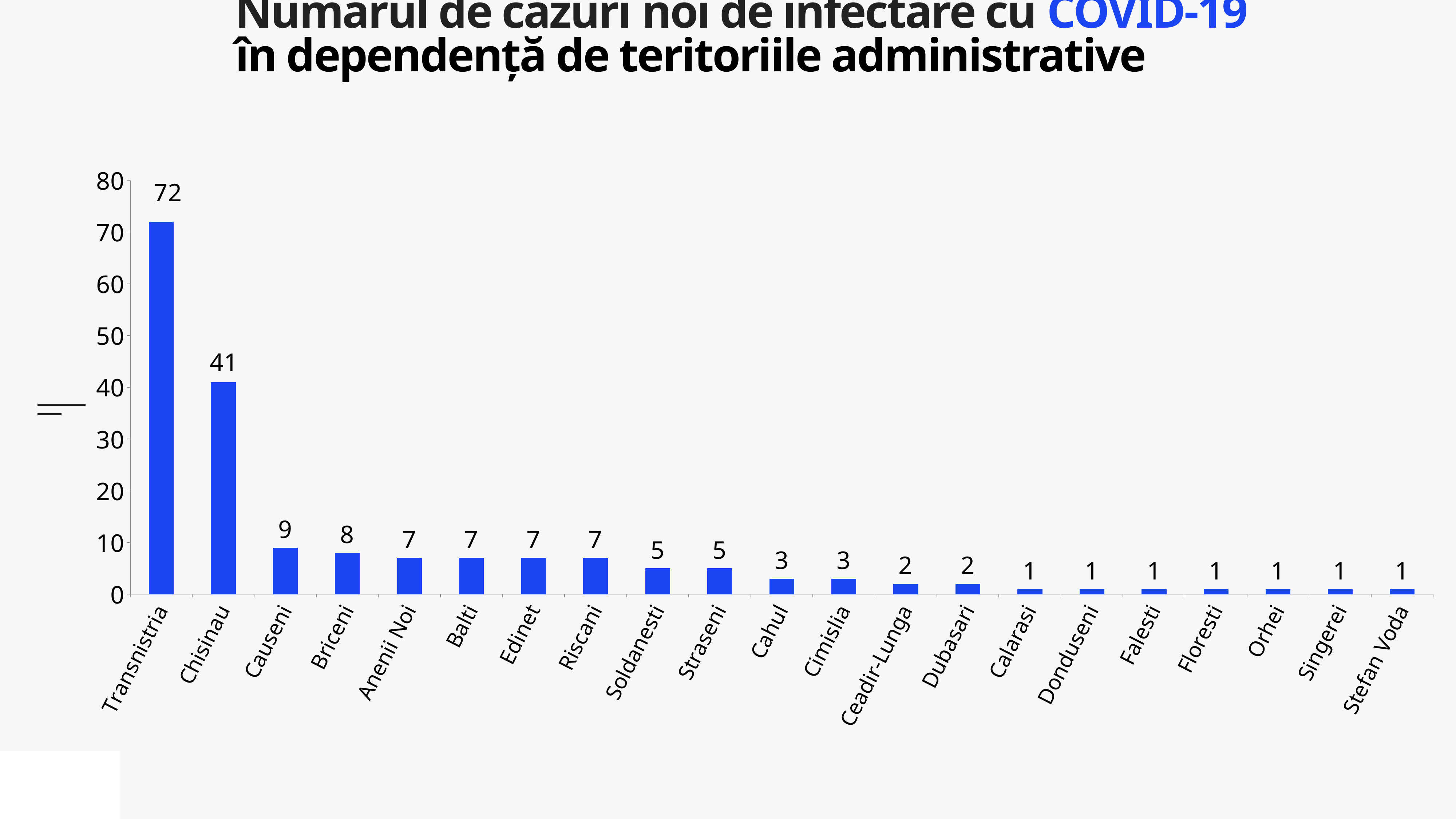
Which is larger, the value for Causeni or the value for Cimislia? Causeni What is the value for Soldanesti? 5 How many categories are shown on the x axis? 21 What is the value for Ceadir-Lunga? 2 What is the difference between the values for Briceni and Cahul? 5 What is the value for Chisinau? 41 What kind of chart is shown on the slide? bar chart What is the difference between the values for Transnistria and Chisinau? 31 Which category has the highest value? Transnistria What is the value for Transnistria? 72 What is the value for Causeni? 9 Is the value for Chisinau greater or less than 50? less